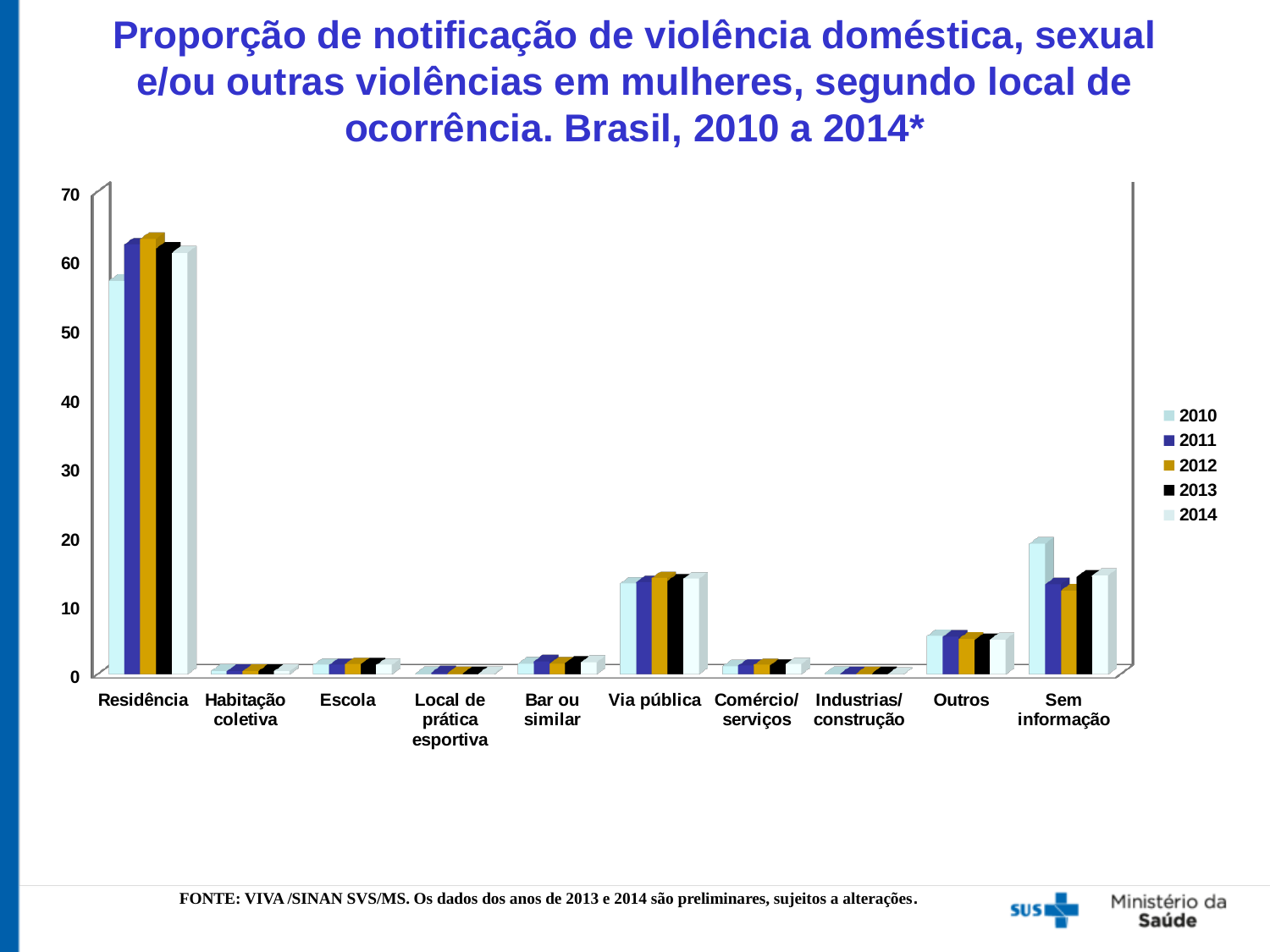
Which is larger for 2010: the value for Via pública or the value for Outros? Via pública What kind of chart is shown on the slide? bar chart Which is larger for 2010: the value for Residência or the value for Sem informação? Residência Is the value for Via pública in 2012 greater or less than 10? greater How many series does the legend list? 5 Is the value for Outros in 2010 greater or less than 10? less Is the value for Residência in 2010 greater or less than 50? greater How many location categories are shown on the x axis of the chart? 10 Which location category has the highest values in the chart? Residência Which year is represented by the black bars in the legend? 2013 For Sem informação, which year has the larger value: 2010 or 2011? 2010